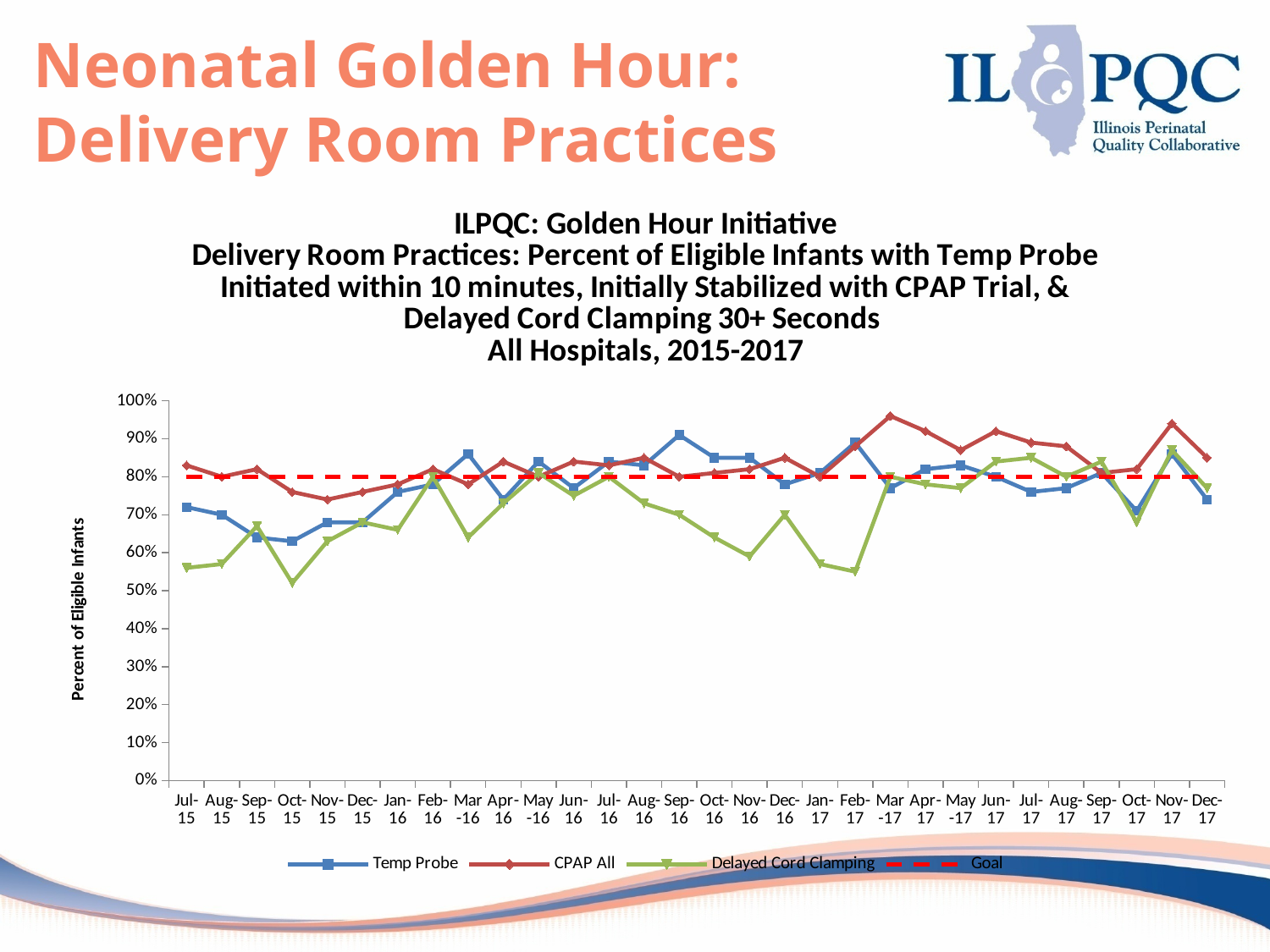
In Feb-17, which is larger: the CPAP All value or the Delayed Cord Clamping value? CPAP All In Jul-15, which is larger: the Temp Probe value or the Delayed Cord Clamping value? Temp Probe At what percentage is the dashed Goal line drawn? 80% Is the CPAP All value for Mar-17 greater or less than 90%? greater In which month does the Delayed Cord Clamping series reach its lowest value? Oct-15 How many monthly data points are plotted along the x axis? 30 Is the Temp Probe value for Jul-15 greater or less than 80%? less What kind of chart is shown on the slide? Line chart Is the Delayed Cord Clamping value for Oct-15 greater or less than 60%? less What is the label on the vertical axis of the chart? Percent of Eligible Infants How many series does the chart legend list? 4